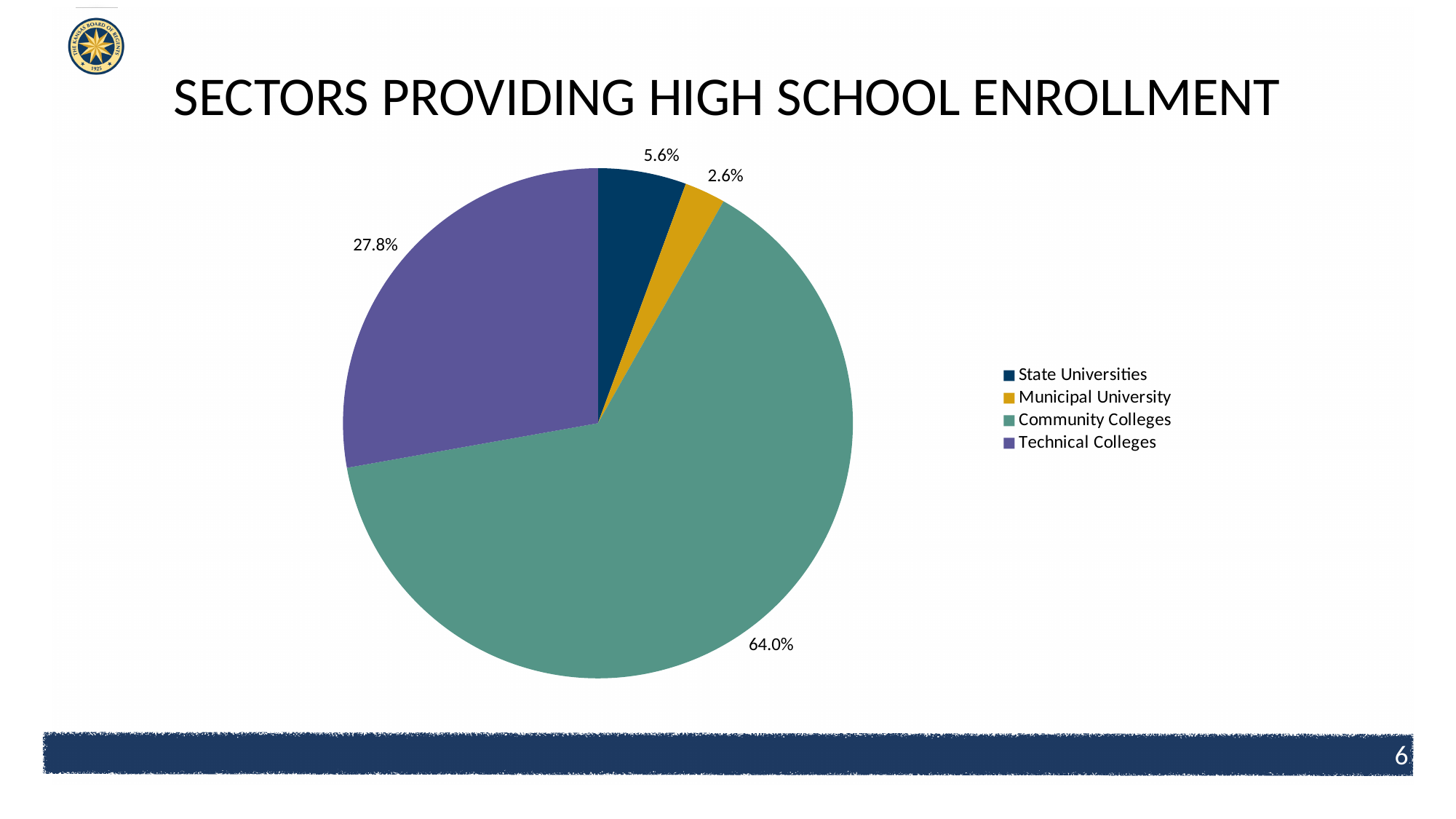
What share of high school enrollment is provided by Municipal University? 2.6% What kind of chart is shown on the slide? pie chart What share of high school enrollment is provided by Technical Colleges? 27.8% What is the title of the chart? SECTORS PROVIDING HIGH SCHOOL ENROLLMENT Which has a larger share, State Universities or Municipal University? State Universities How many sectors are shown in the pie chart? 4 Which sector has the smallest share of high school enrollment? Municipal University Which sector has the largest share of high school enrollment? Community Colleges What share of high school enrollment is provided by Community Colleges? 64.0% What colour is the Technical Colleges slice? purple What is the difference in percentage points between the Community Colleges share and the Technical Colleges share? 36.2 What share of high school enrollment is provided by State Universities? 5.6%